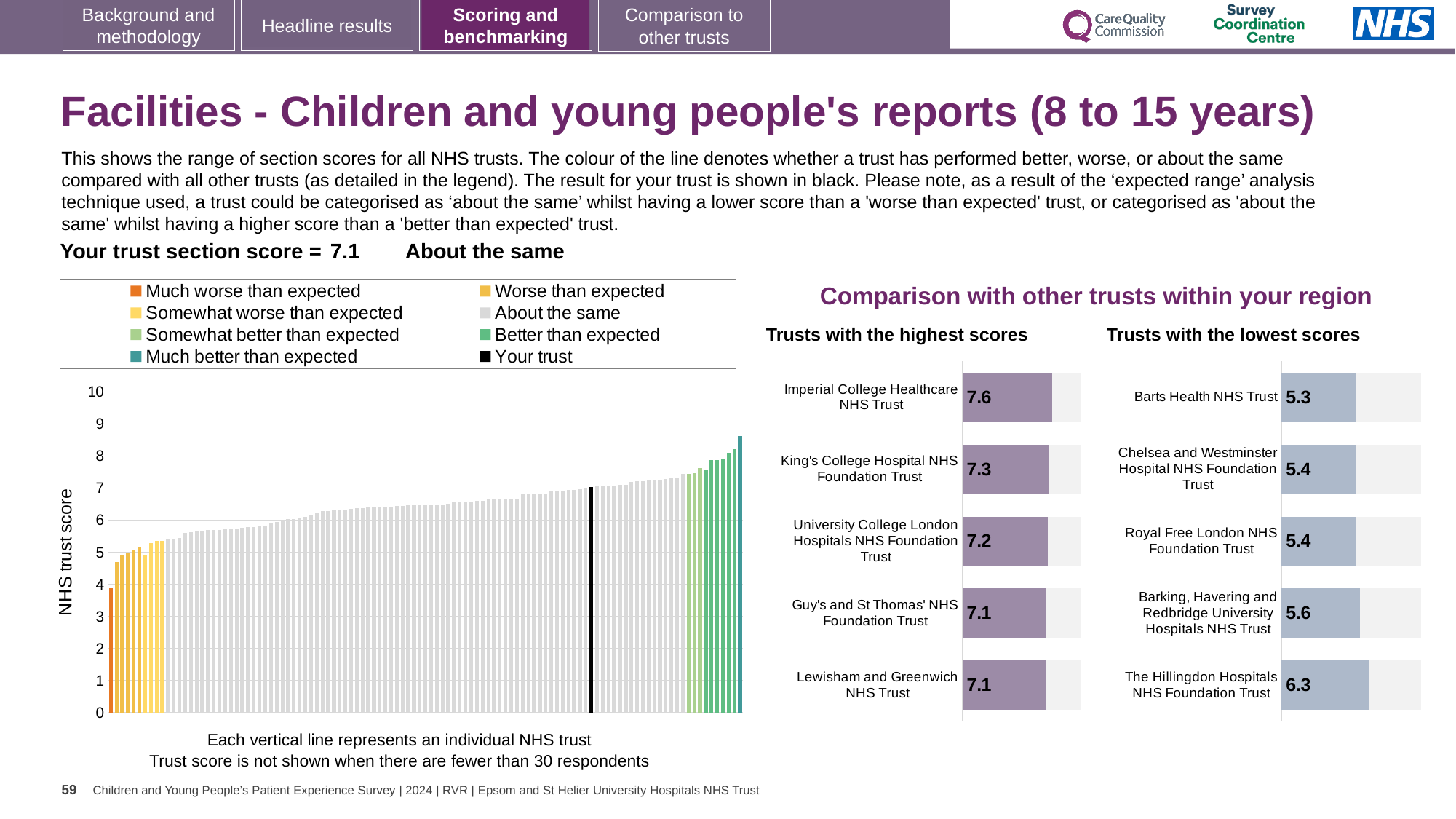
In the 'Trusts with the lowest scores' chart, what is the score for The Hillingdon Hospitals NHS Foundation Trust? 6.3 In the 'Trusts with the highest scores' chart, what is the score for Imperial College Healthcare NHS Trust? 7.6 In the 'Trusts with the lowest scores' chart, what is the score for Barts Health NHS Trust? 5.3 In the 'Trusts with the lowest scores' chart, which trust has the lowest score? Barts Health NHS Trust In the 'Trusts with the highest scores' chart, what is the difference between the scores of Imperial College Healthcare NHS Trust and Lewisham and Greenwich NHS Trust? 0.5 In the 'Trusts with the highest scores' chart, which trust has the highest score? Imperial College Healthcare NHS Trust In the 'Trusts with the highest scores' chart, what is the score for King's College Hospital NHS Foundation Trust? 7.3 In the main 'NHS trust score' chart, is the value of the tallest bar greater or less than 8? greater How many trusts are shown in the 'Trusts with the highest scores' chart? 5 In the 'Trusts with the lowest scores' chart, what is the difference between the scores of The Hillingdon Hospitals NHS Foundation Trust and Barts Health NHS Trust? 1.0 How many entries does the legend of the main 'NHS trust score' chart list? 8 Which is larger: the score for Guy's and St Thomas' NHS Foundation Trust in the highest scores chart, or the score for Barking, Havering and Redbridge University Hospitals NHS Trust in the lowest scores chart? Guy's and St Thomas' NHS Foundation Trust